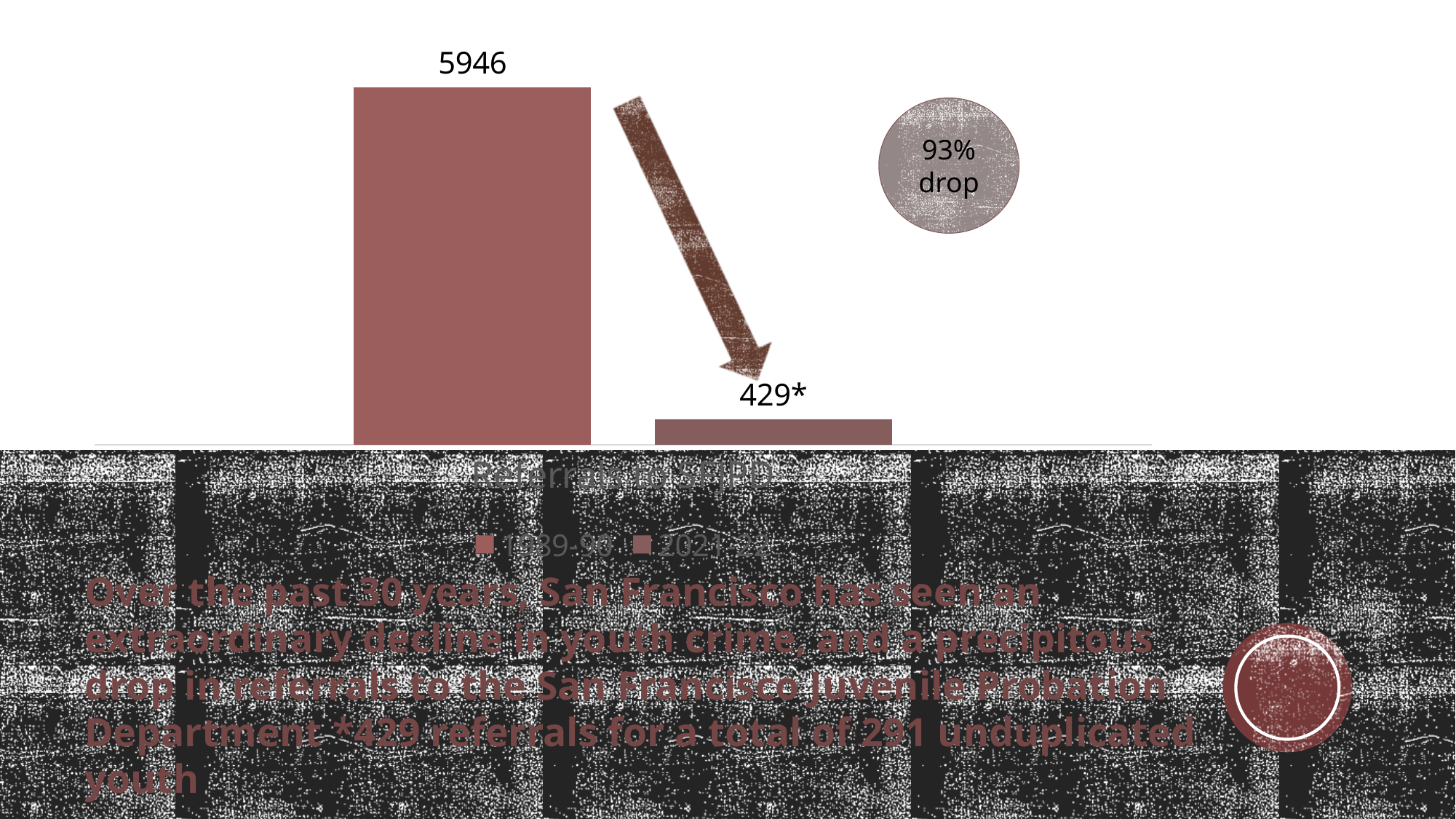
What is the value for the 1989-90 series? 5946 Which series has the lowest value in the chart? 2021-22 What is the value for the 2021-22 series? 429* What kind of chart is shown on the slide? Bar chart What is the value of the shorter bar in the chart? 429* What is the title of the chart? Referrals to SFJPD What percentage drop is shown in the circle next to the chart? 93% drop How many bars are plotted in the chart? 2 What is the difference between the 1989-90 value and the 2021-22 value? 5517 What is the value of the taller bar in the chart? 5946 How many series does the legend list? 2 Which series has the higher value, 1989-90 or 2021-22? 1989-90